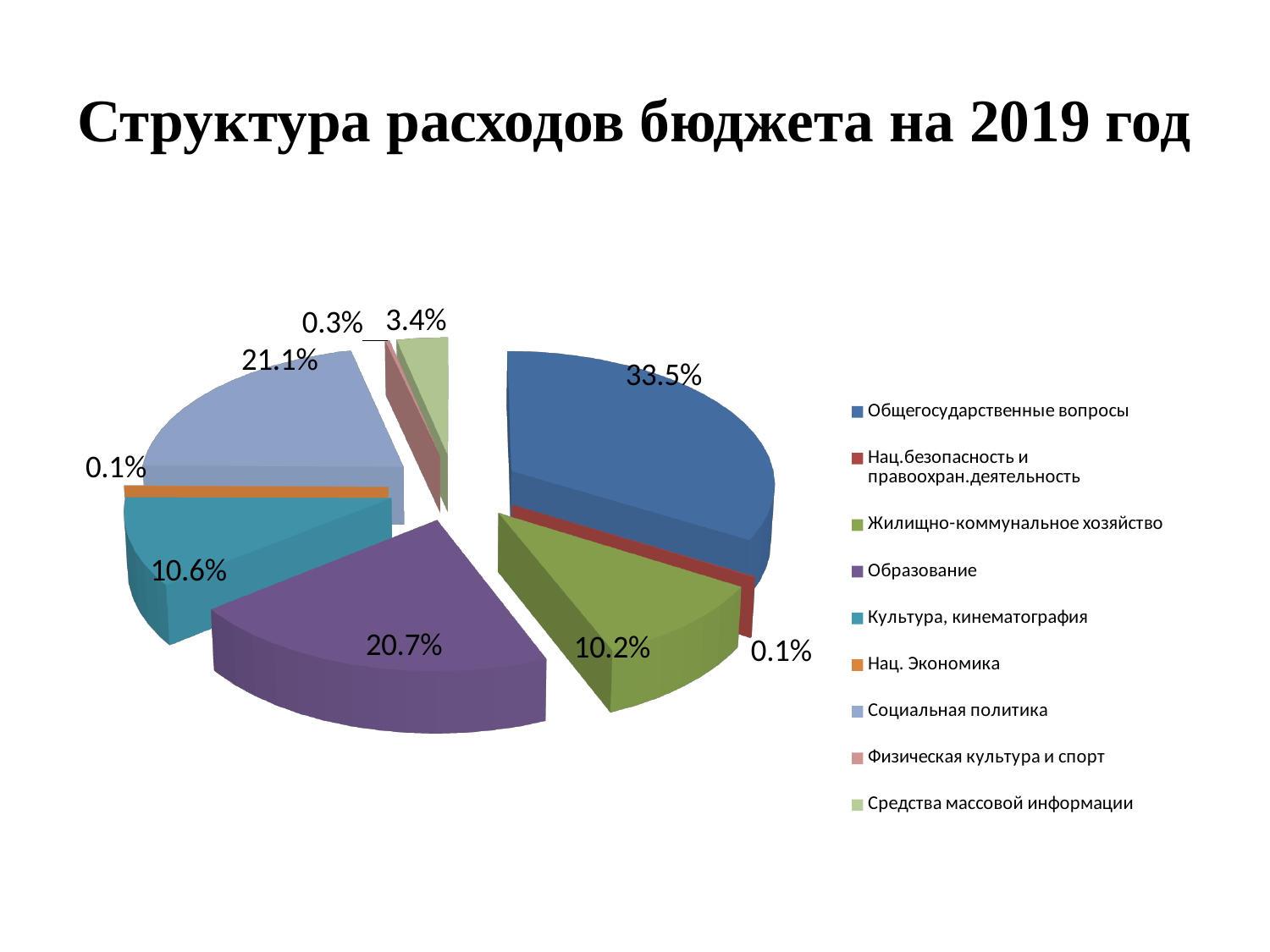
Which category has the largest share of the budget? Общегосударственные вопросы What is the difference between the share for Общегосударственные вопросы and the share for Жилищно-коммунальное хозяйство? 23.3% What share of the budget goes to Общегосударственные вопросы? 33.5% What share of the budget goes to Социальная политика? 21.1% What share of the budget goes to Средства массовой информации? 3.4% What is the title of the chart? Структура расходов бюджета на 2019 год What share of the budget goes to Культура, кинематография? 10.6% What kind of chart is shown on the slide? pie chart What colour is the slice for Образование? purple What share of the budget goes to Образование? 20.7% How many categories does the legend list? 9 Which is larger, the share for Социальная политика or the share for Образование? Социальная политика